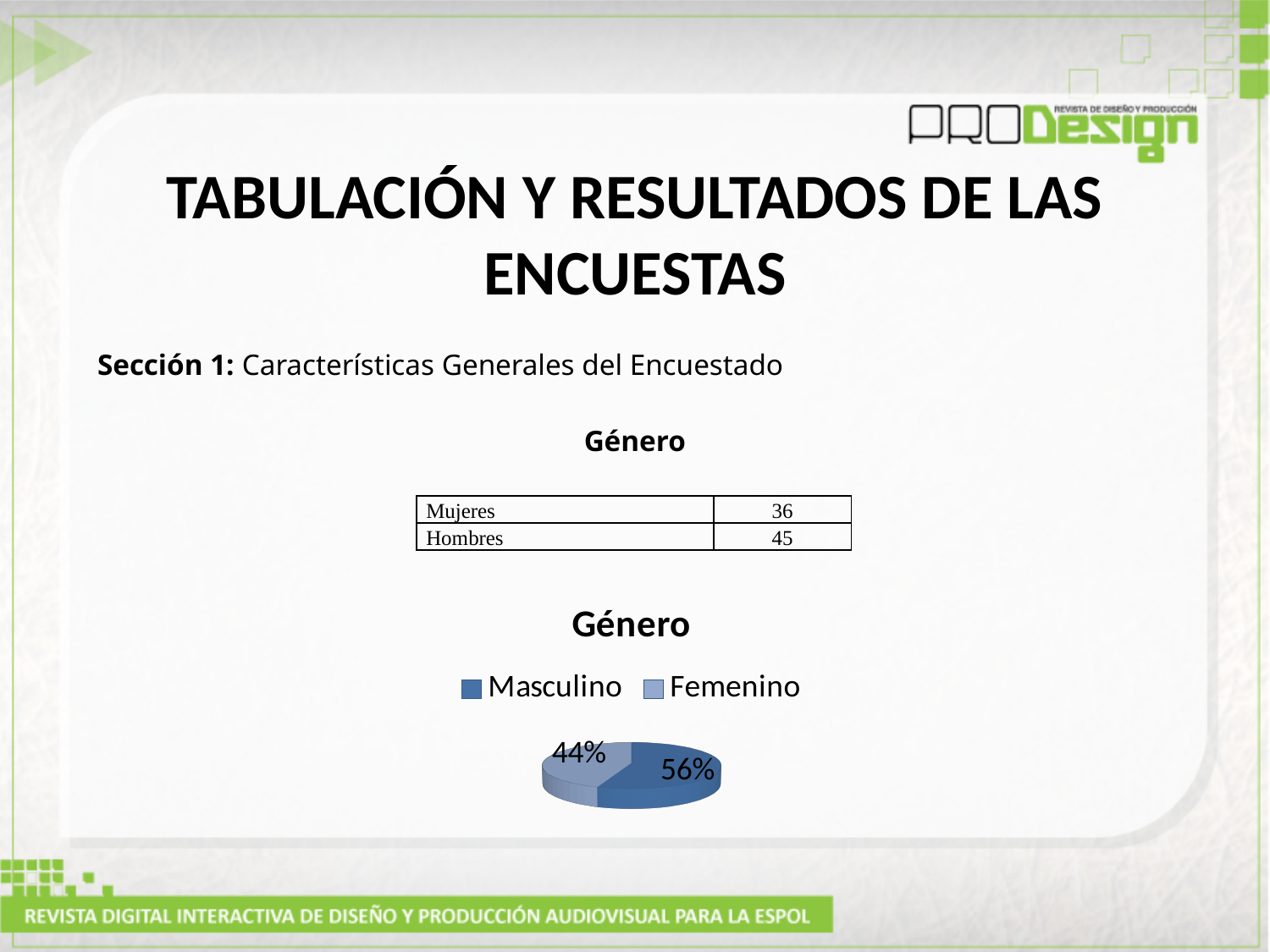
Which slice of the pie chart is the smallest? Femenino How many series does the legend of the pie chart list? 2 What share of the pie chart does Masculino represent? 56% What kind of chart is shown under the title "Género"? pie chart Is the Femenino share in the pie chart greater or less than 50%? less What is the difference in percentage points between the Masculino and Femenino slices of the pie chart? 12% Which legend entry of the pie chart is shown in the lighter blue colour? Femenino What share of the pie chart does Femenino represent? 44% What is the title of the pie chart? Género In the pie chart, which is larger, Masculino or Femenino? Masculino Which slice of the pie chart is the largest? Masculino How many slices does the pie chart have? 2